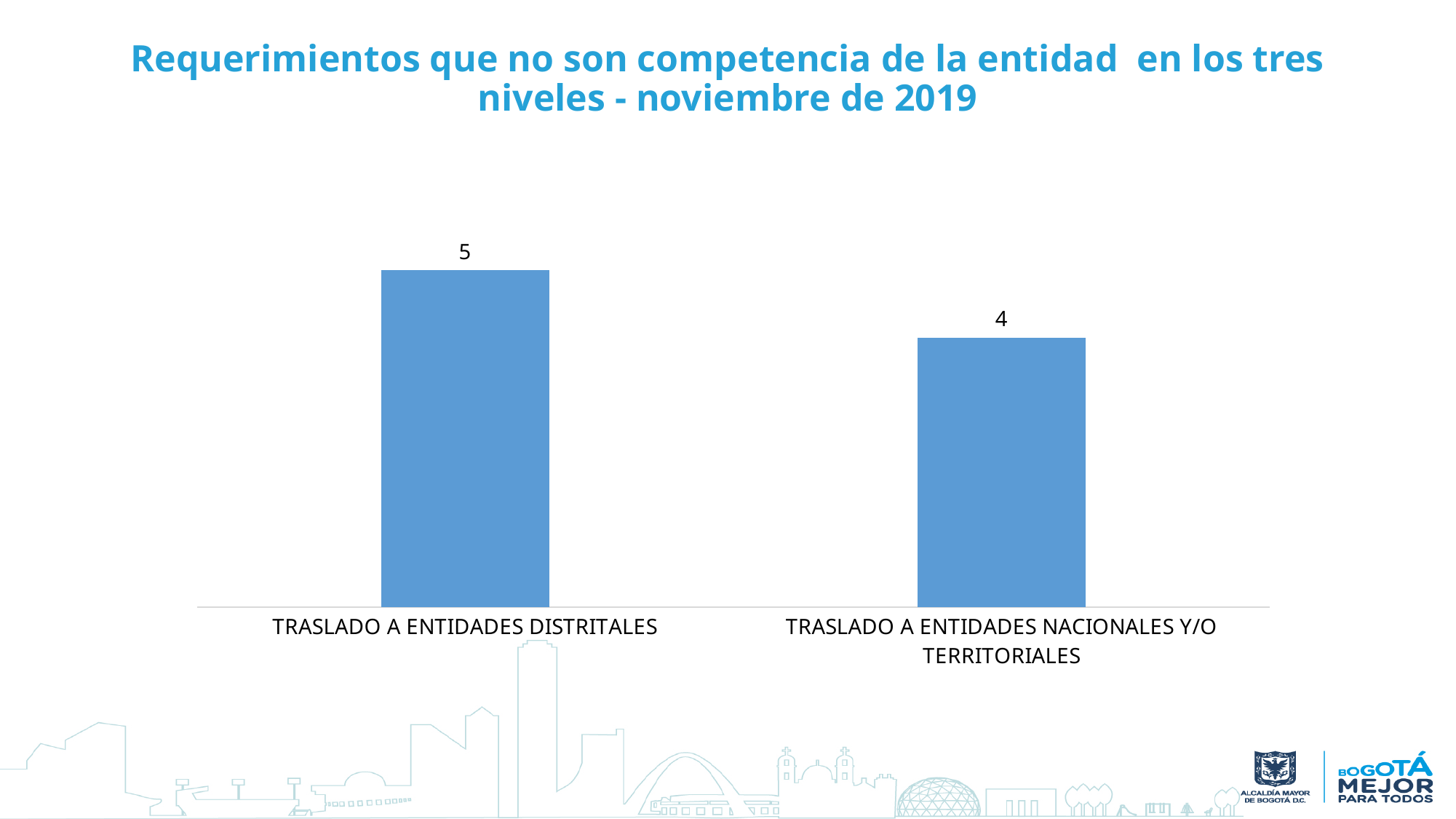
Which is larger: the value for TRASLADO A ENTIDADES DISTRITALES or the value for TRASLADO A ENTIDADES NACIONALES Y/O TERRITORIALES? TRASLADO A ENTIDADES DISTRITALES What is the total of the two bars in the chart? 9 What is the title of the slide? Requerimientos que no son competencia de la entidad en los tres niveles - noviembre de 2019 Which category has the lowest value? TRASLADO A ENTIDADES NACIONALES Y/O TERRITORIALES Which category has the highest value? TRASLADO A ENTIDADES DISTRITALES How many categories are shown in the chart? 2 What kind of chart is shown on the slide? Bar chart What is the difference between the values for TRASLADO A ENTIDADES DISTRITALES and TRASLADO A ENTIDADES NACIONALES Y/O TERRITORIALES? 1 What is the value for TRASLADO A ENTIDADES NACIONALES Y/O TERRITORIALES? 4 What colour are the bars in the chart? Blue Do the values rise or fall from left to right across the categories? Fall What is the value for TRASLADO A ENTIDADES DISTRITALES? 5